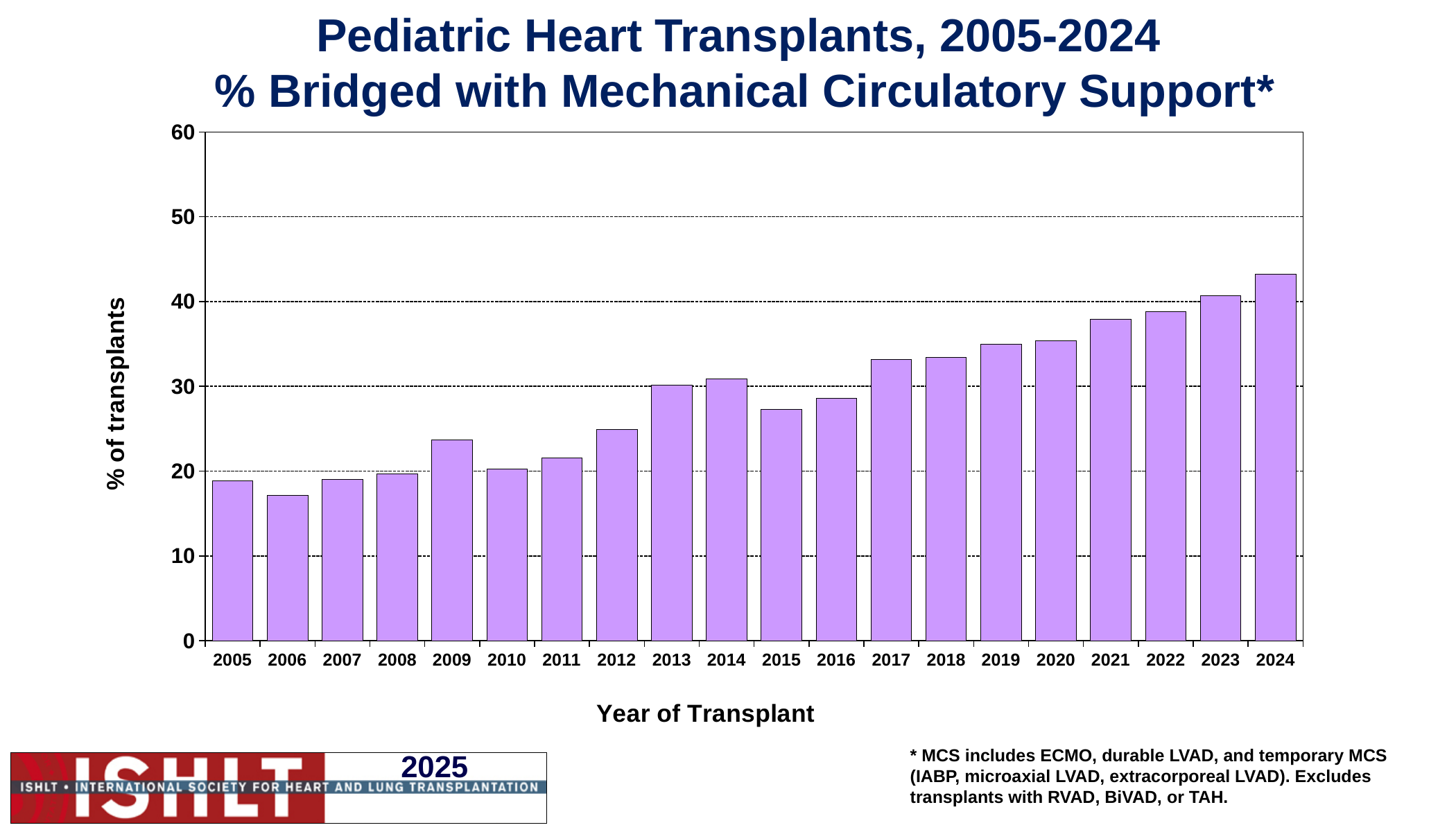
Is the value for 2006 greater or less than 20? less Which year has the lowest % of transplants bridged with mechanical circulatory support? 2006 Which year has the larger value, 2009 or 2010? 2009 Which year has the highest % of transplants bridged with mechanical circulatory support? 2024 Which year has the larger value, 2014 or 2015? 2014 Is the value for 2021 greater or less than 40? less How many years (bars) are plotted on the chart? 20 Is the value for 2015 greater or less than 30? less What is the label of the y axis? % of transplants What kind of chart is shown on the slide? bar chart Overall, do the values rise or fall from 2005 to 2024? rise